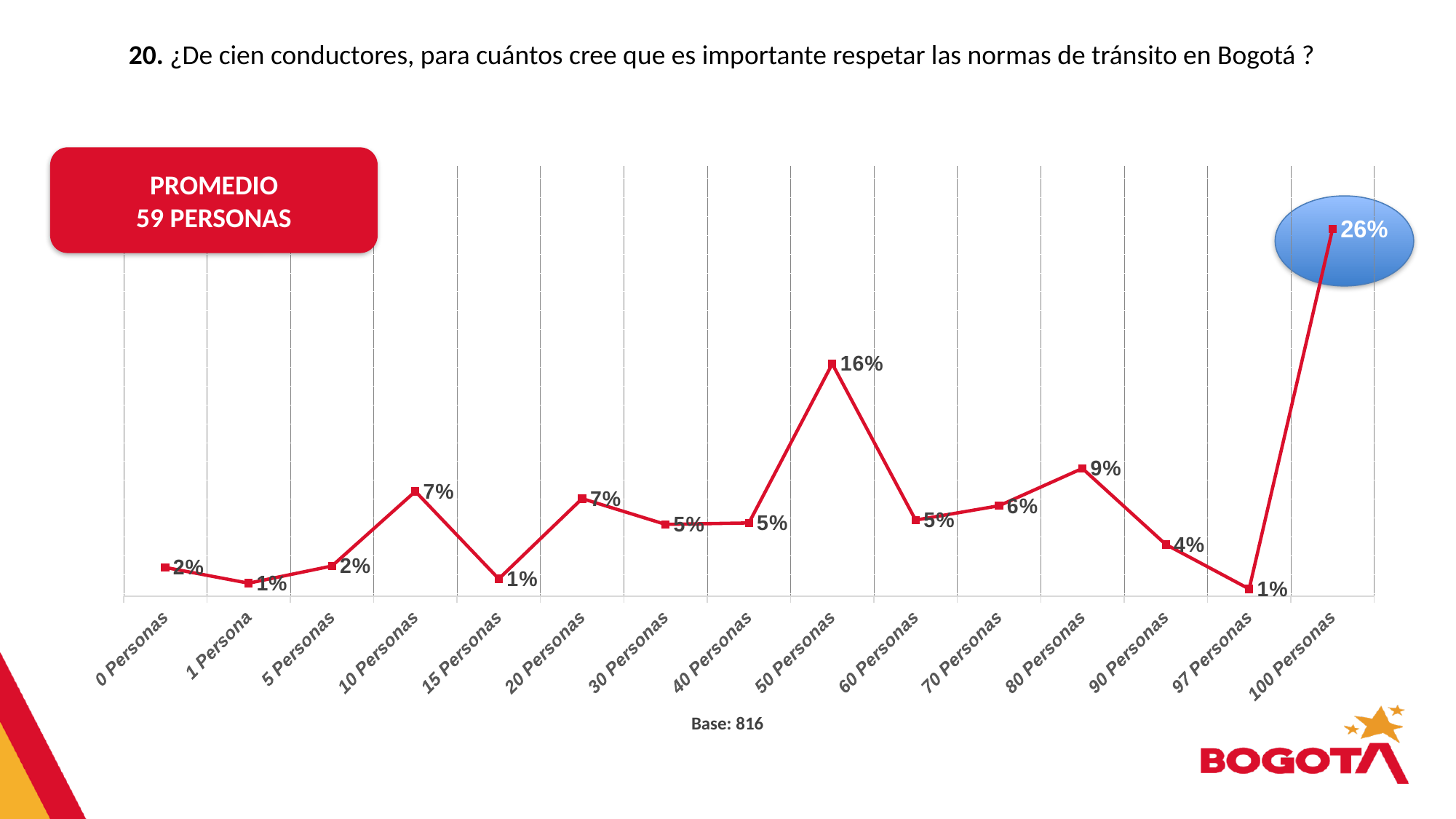
What is the value for 80 Personas? 9% What base (number of respondents) is stated below the chart? 816 Which is larger, the value for 10 Personas or the value for 15 Personas? 10 Personas How many categories are shown on the x axis? 15 What kind of chart is shown on the slide? Line chart What is the value for 90 Personas? 4% What is the difference between the values for 100 Personas and 50 Personas? 10% What is the difference between the values for 80 Personas and 97 Personas? 8% Which is larger, the value for 80 Personas or the value for 70 Personas? 80 Personas Which category has the highest value? 100 Personas What is the value for 50 Personas? 16% What is the value for 100 Personas? 26%